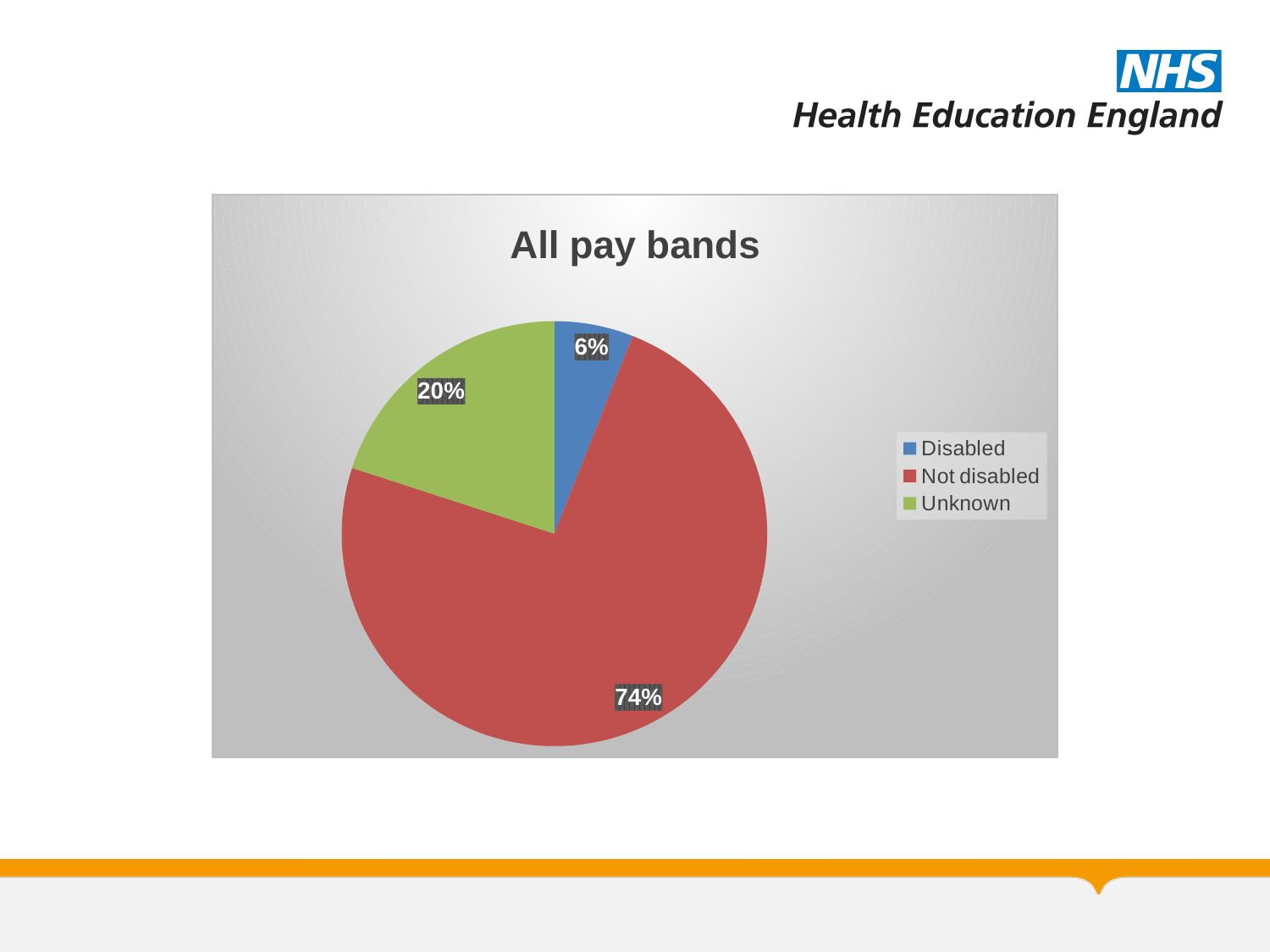
What kind of chart is shown on the slide? Pie chart What percentage of the pie is labelled Unknown? 20% What is the title of the chart? All pay bands Which category has the largest share of the pie? Not disabled What is the difference in percentage points between the Unknown and Disabled slices? 14 What percentage of the pie is labelled Not disabled? 74% What colour is the Unknown slice? Green What is the difference in percentage points between the Not disabled and Unknown slices? 54 Which is larger, the Unknown slice or the Disabled slice? Unknown What percentage of the pie is labelled Disabled? 6% Which category has the smallest share of the pie? Disabled How many categories does the legend list? 3